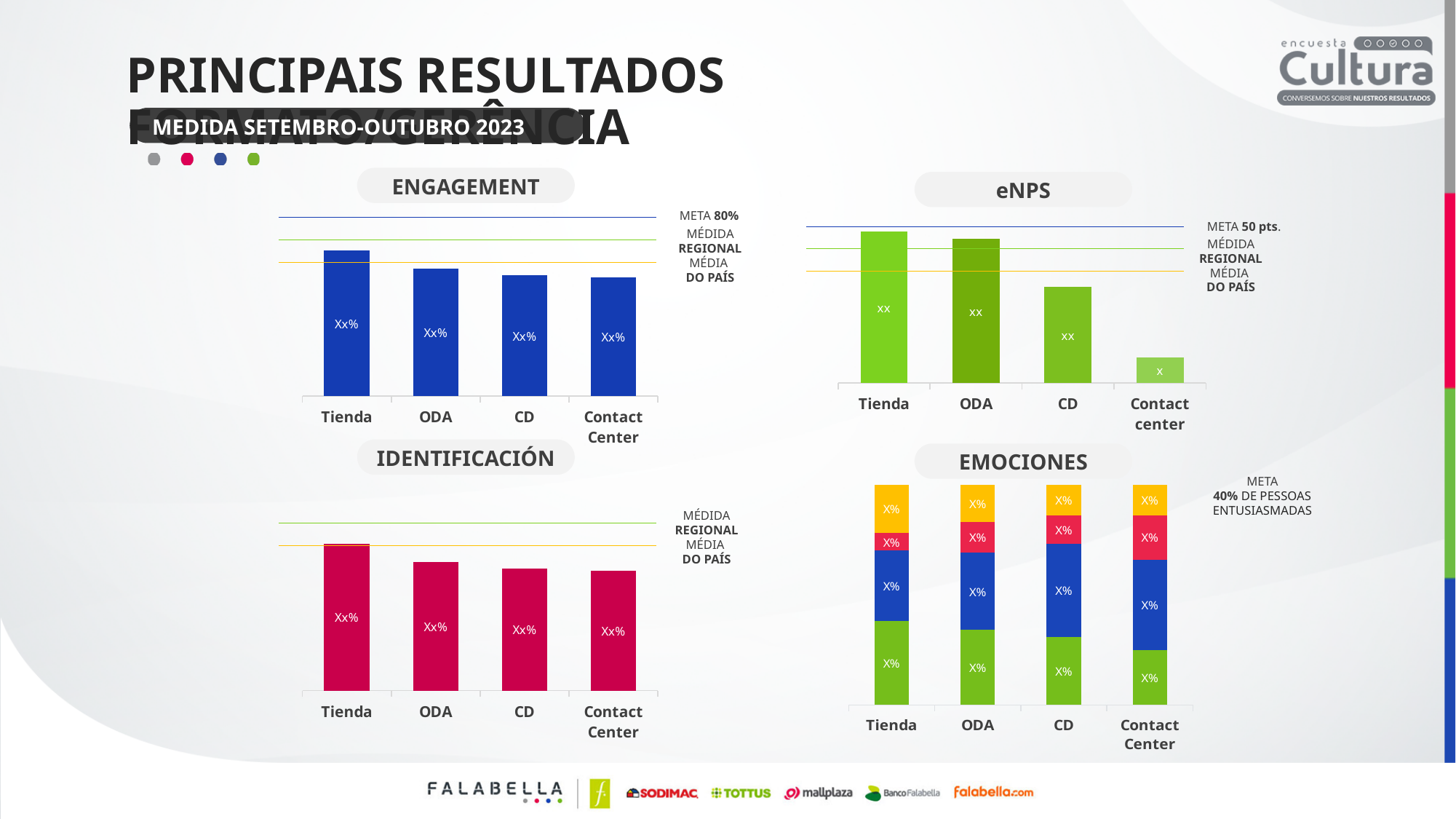
In the eNPS chart, is the value for ODA larger or smaller than the value for CD? larger In the eNPS chart, is the value for Contact center greater or less than the 50 pts target line? less In the IDENTIFICACIÓN chart, which category has the highest value? Tienda How many categories are shown in the ENGAGEMENT chart? 4 In the ENGAGEMENT chart, is the value for Tienda greater or less than the 80% target line? less In the eNPS chart, which category has the lowest value? Contact center In the eNPS chart, which category has the highest value? Tienda What kind of chart is the ENGAGEMENT chart? bar chart How many segments does each bar in the EMOCIONES chart have? 4 What kind of chart is the EMOCIONES chart? stacked bar chart What target is stated next to the EMOCIONES chart? 40% de pessoas entusiasmadas In the ENGAGEMENT chart, which category has the highest value? Tienda